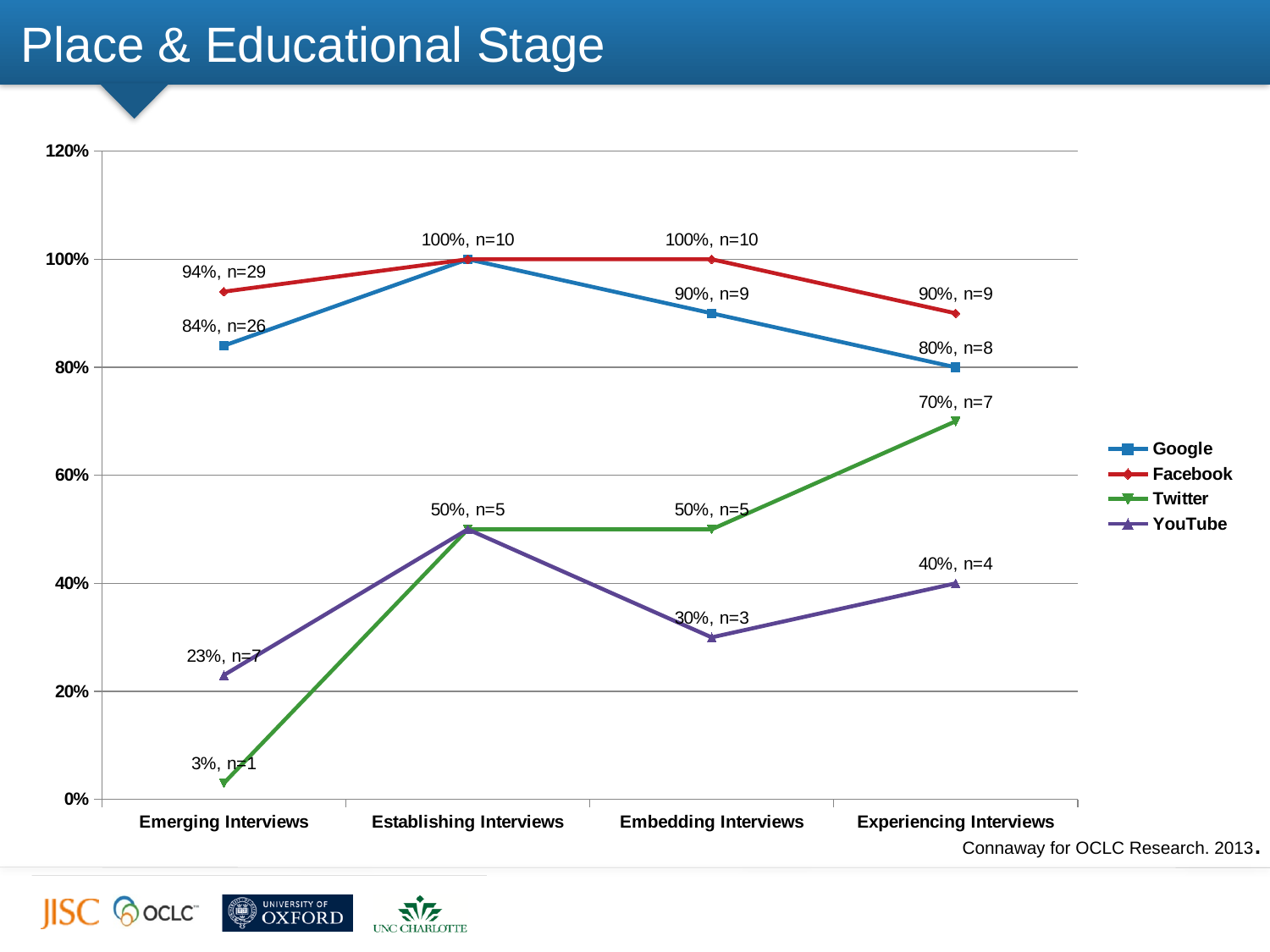
What is the value for Twitter at Experiencing Interviews? 70%, n=7 How many categories are shown on the x axis? 4 What type of chart is shown on the slide? Line chart What is the difference in percentage between Facebook and Google at Experiencing Interviews? 10% Which series has the highest value at Experiencing Interviews? Facebook Does the Twitter line rise or fall from Emerging Interviews to Establishing Interviews? Rise What is the value for Google at Emerging Interviews? 84%, n=26 Which series has the lowest value at Emerging Interviews? Twitter Which is larger at Embedding Interviews, the Twitter value or the YouTube value? Twitter What is the value for YouTube at Embedding Interviews? 30%, n=3 How many series does the legend list? 4 What is the value for Facebook at Emerging Interviews? 94%, n=29